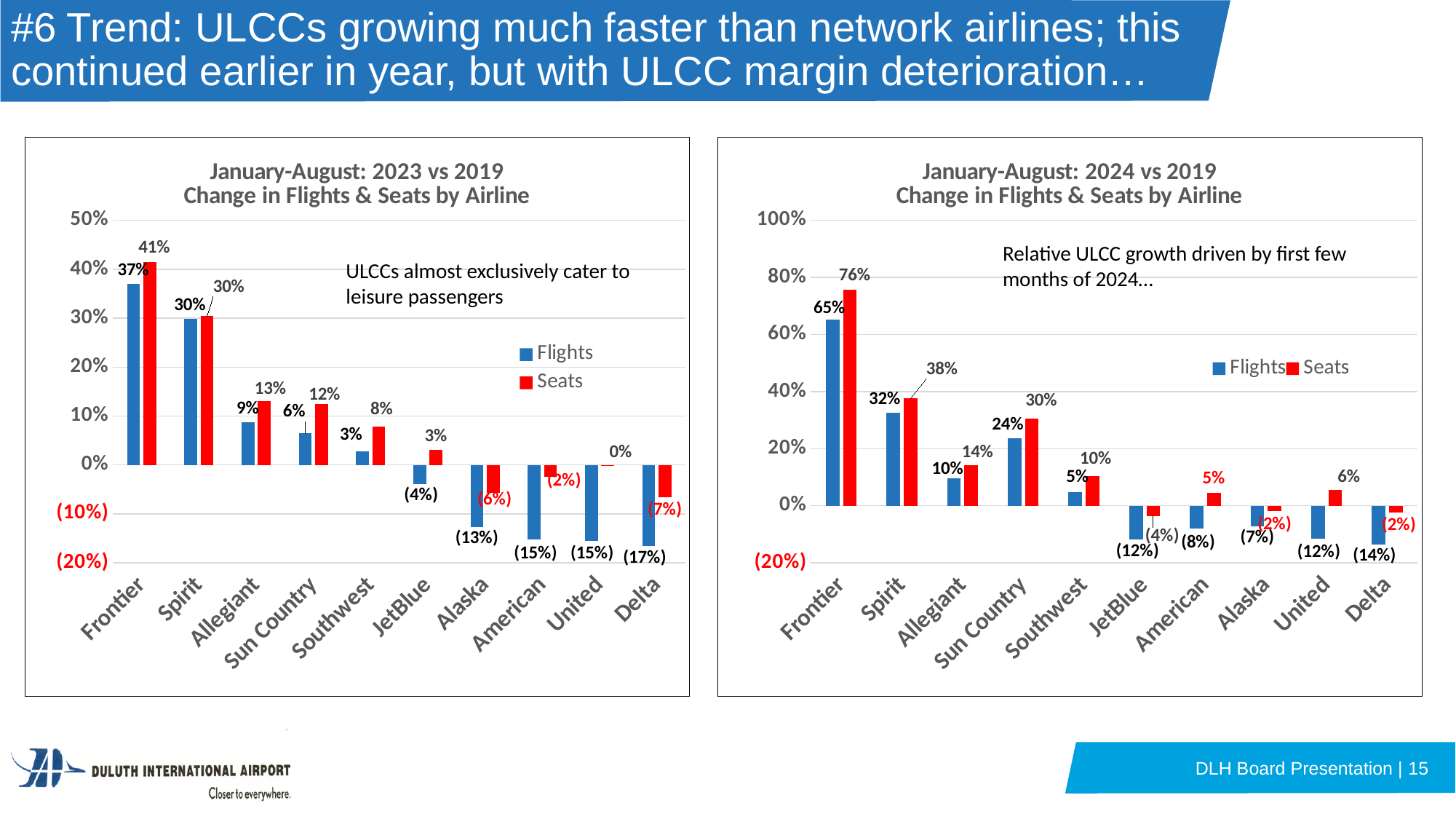
What type of chart is the 'January-August: 2023 vs 2019' chart? Bar chart How many series does the legend list in the 'January-August: 2024 vs 2019' chart? 2 In the 'January-August: 2024 vs 2019' chart, what is the Seats value for Frontier? 76% In the 'January-August: 2023 vs 2019' chart, what is the difference between the Seats and Flights values for Sun Country? 6% In the 'January-August: 2024 vs 2019' chart, what is the Flights value for Sun Country? 24% In the 'January-August: 2023 vs 2019' chart, what is the Flights value for Delta? (17%) In the 'January-August: 2023 vs 2019' chart, which airline has the highest Flights value? Frontier In the 'January-August: 2024 vs 2019' chart, which airline has the lowest Flights value? Delta In the 'January-August: 2023 vs 2019' chart, how many airlines are shown on the x axis? 10 In the 'January-August: 2024 vs 2019' chart, what is the difference between the Seats value for Frontier and the Seats value for Spirit? 38% In the 'January-August: 2023 vs 2019' chart, what is the Seats value for Frontier? 41% In the 'January-August: 2024 vs 2019' chart, which is larger for Spirit: the Flights value or the Seats value? Seats